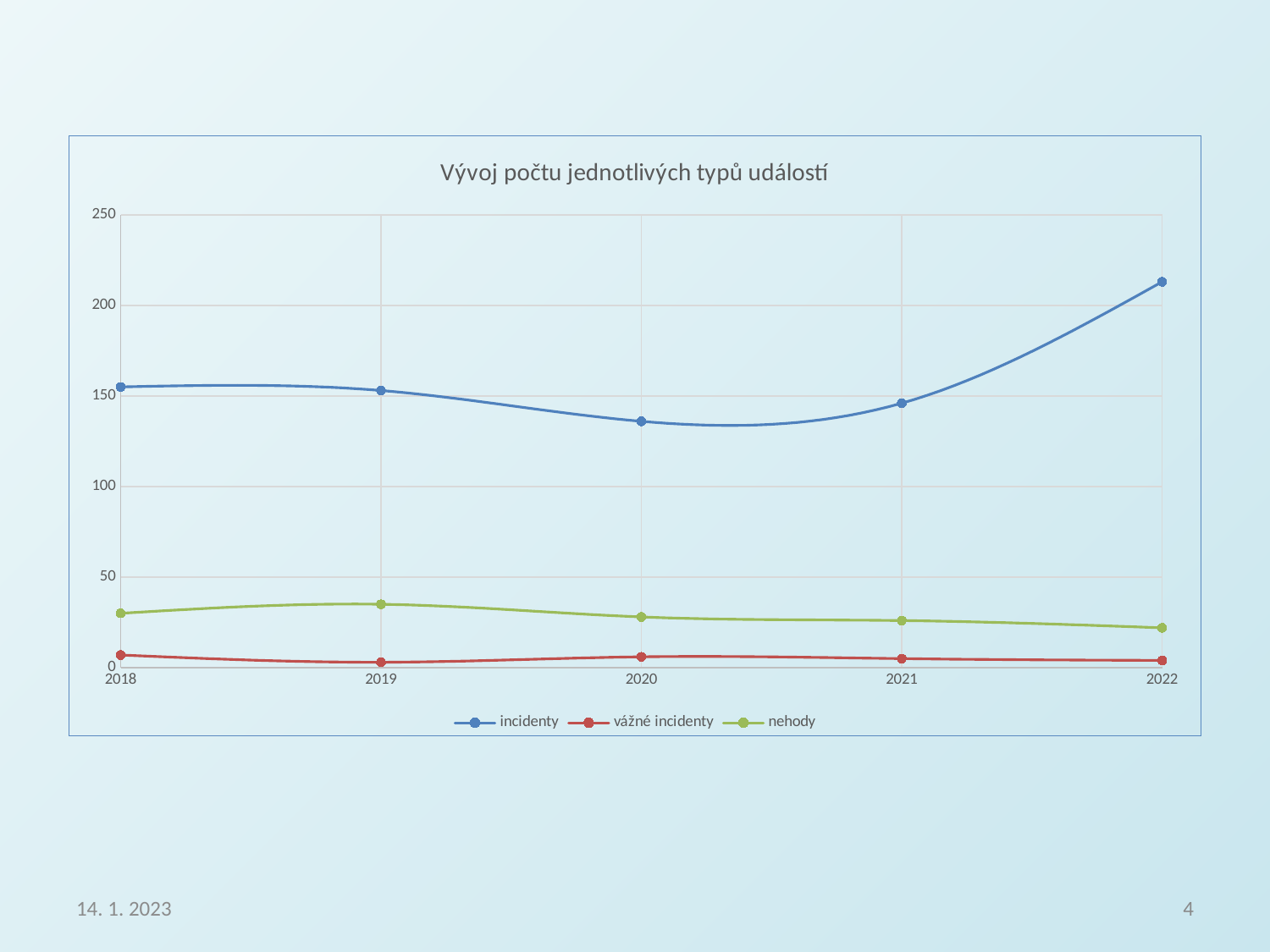
Is the value for nehody in 2019 greater or less than 50? less What kind of chart is shown on the slide? line chart Do the values for nehody rise or fall from 2019 to 2022? fall Is the value for incidenty in 2022 greater or less than 200? greater Is the value for incidenty in 2020 greater or less than 150? less Which is larger in 2021: nehody or vážné incidenty? nehody How many years are shown on the x axis? 5 What is the title of the chart? Vývoj počtu jednotlivých typů událostí In which year is the value for incidenty highest? 2022 Which series has the highest values across all years? incidenty In which year is the value for incidenty lowest? 2020 How many series does the legend list? 3